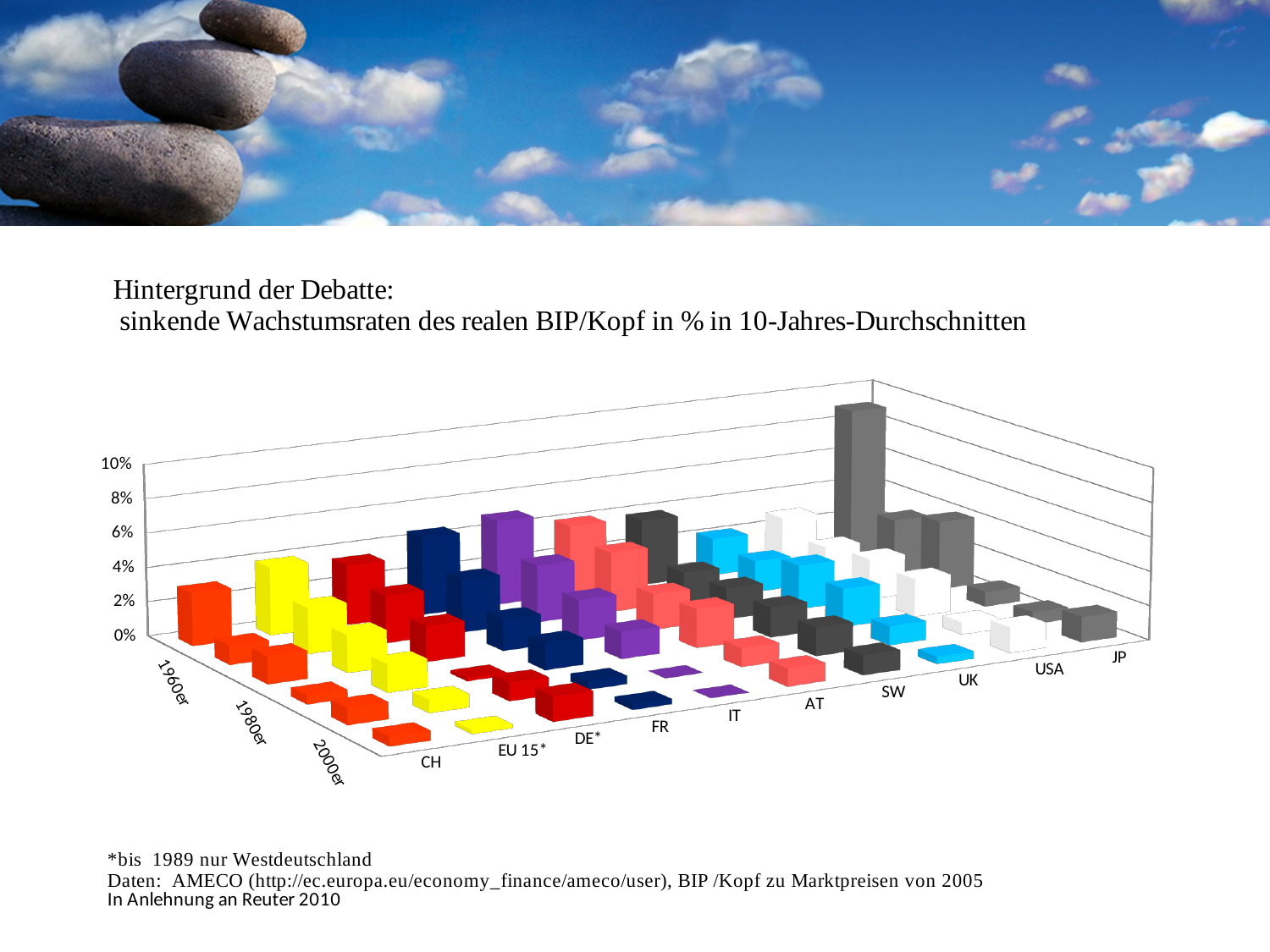
How many countries/regions are shown along the horizontal axis of the chart? 10 Which decade labels are shown on the depth axis of the chart? 1960er, 1980er, 2000er What is the highest value shown on the vertical axis of the chart? 10% Is the 1960er value for CH greater or less than 6%? less What kind of chart is shown on the slide? bar chart Which is larger for JP: the 1960er bar or the 2000er bar? 1960er Which country label appears last (rightmost) on the horizontal axis? JP Which country label appears first (leftmost) on the horizontal axis? CH Which country has the tallest bar in the chart? JP Is the tallest bar for JP greater or less than 6%? greater Do the growth rates generally rise or fall from the 1960er to the 2000er? fall